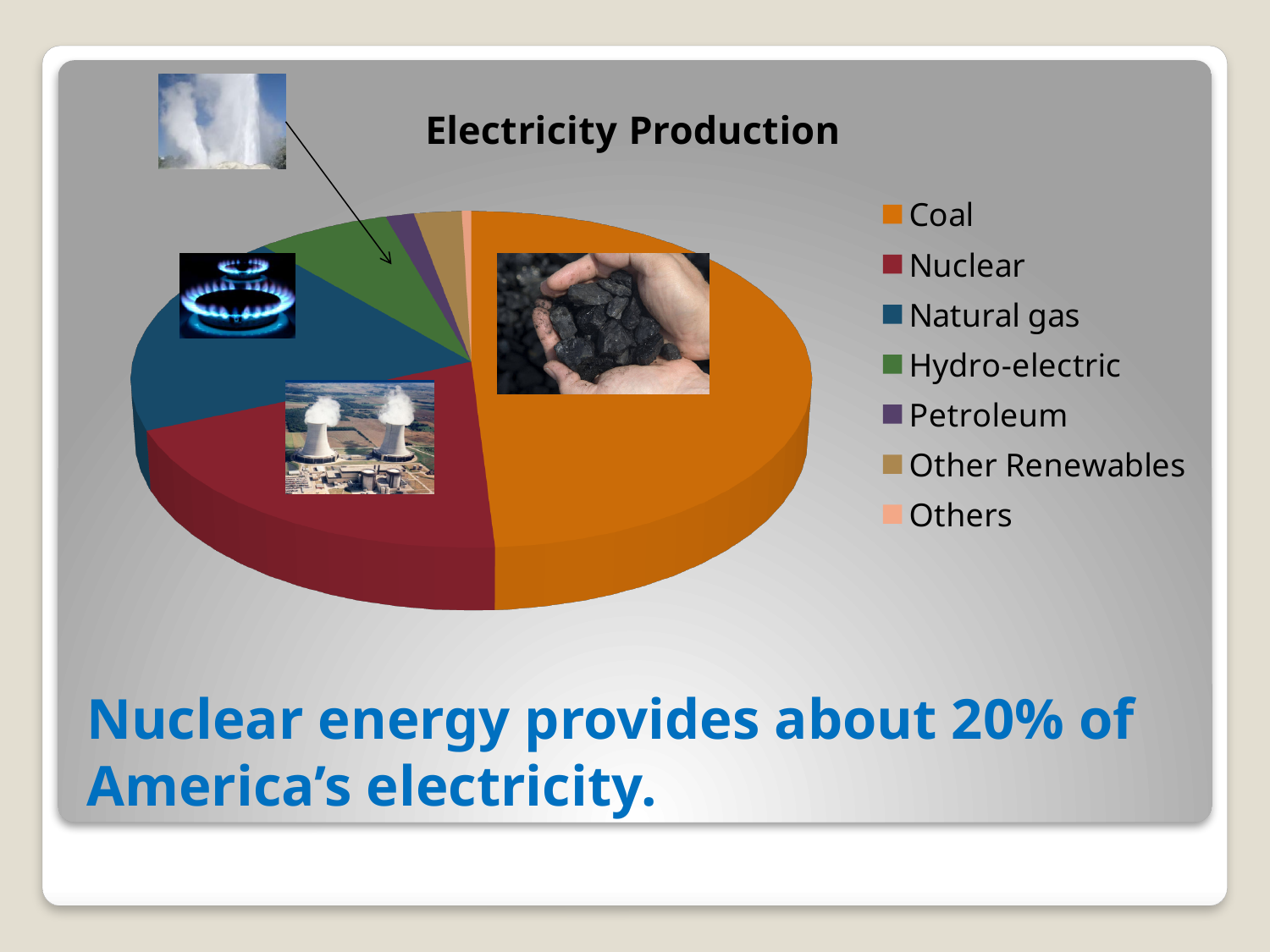
How many entries does the chart's legend list? 7 What colour is the Coal slice in the pie chart? orange Which slice is larger, Nuclear or Others? Nuclear How many categories does the pie chart have? 7 Which slice is larger, Hydro-electric or Petroleum? Hydro-electric Which category has the smallest slice of the pie? Others Which slice is larger, Coal or Nuclear? Coal What kind of chart is shown on the slide? pie chart Which category has the largest slice of the pie? Coal What is the title of the chart? Electricity Production